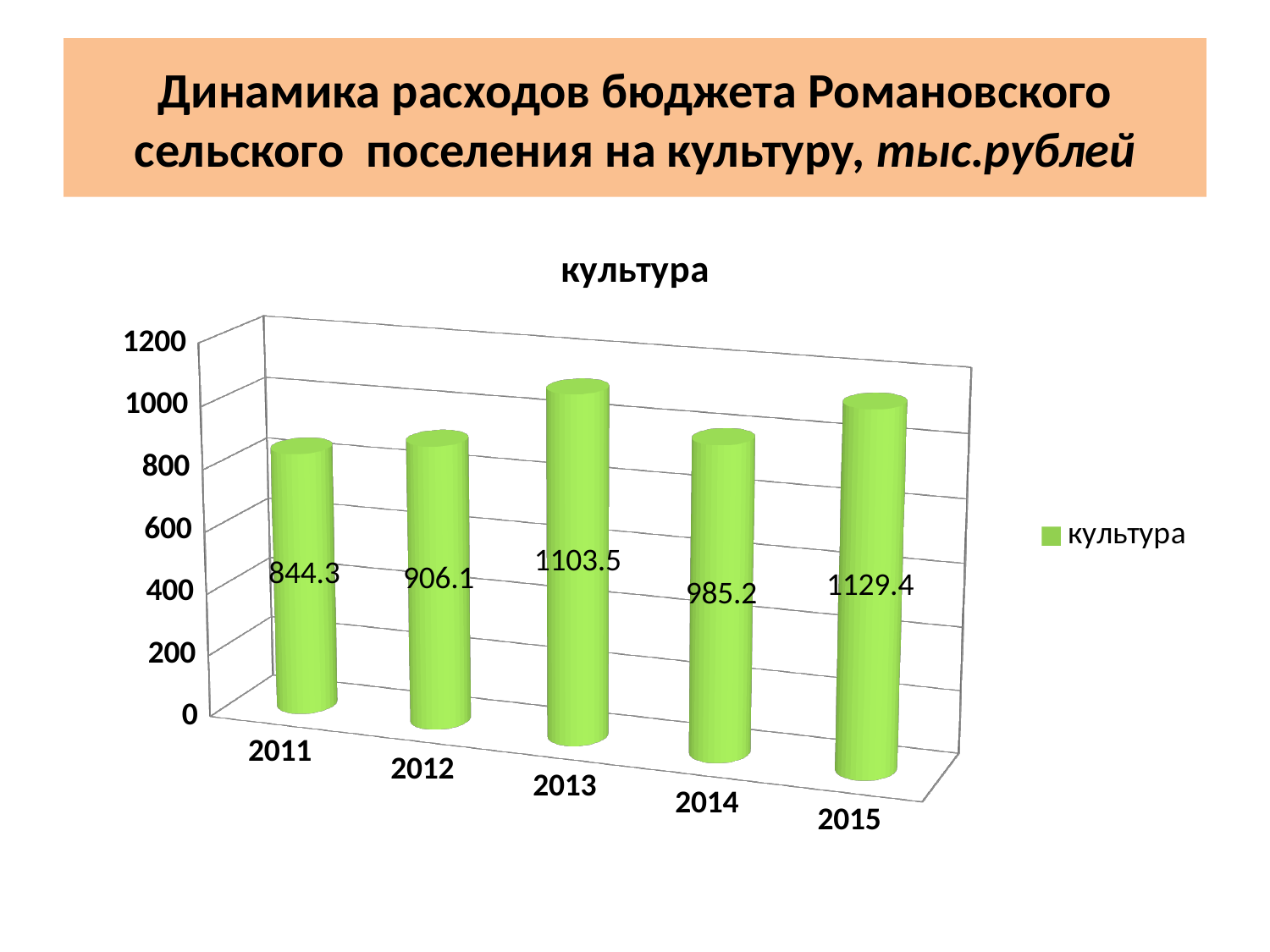
What is the difference between the values for 2013 and 2014? 118.3 What is the value for 2015? 1129.4 What is the value for 2011? 844.3 Is the value for 2014 greater or less than 1000? less Which year has the lowest value? 2011 How many years are shown on the x axis? 5 What is the difference between the values for 2012 and 2011? 61.8 What is the title of the chart? культура What is the value for 2013? 1103.5 Which year has the highest value? 2015 Which is larger, the value for 2014 or the value for 2012? 2014 What kind of chart is shown? bar chart